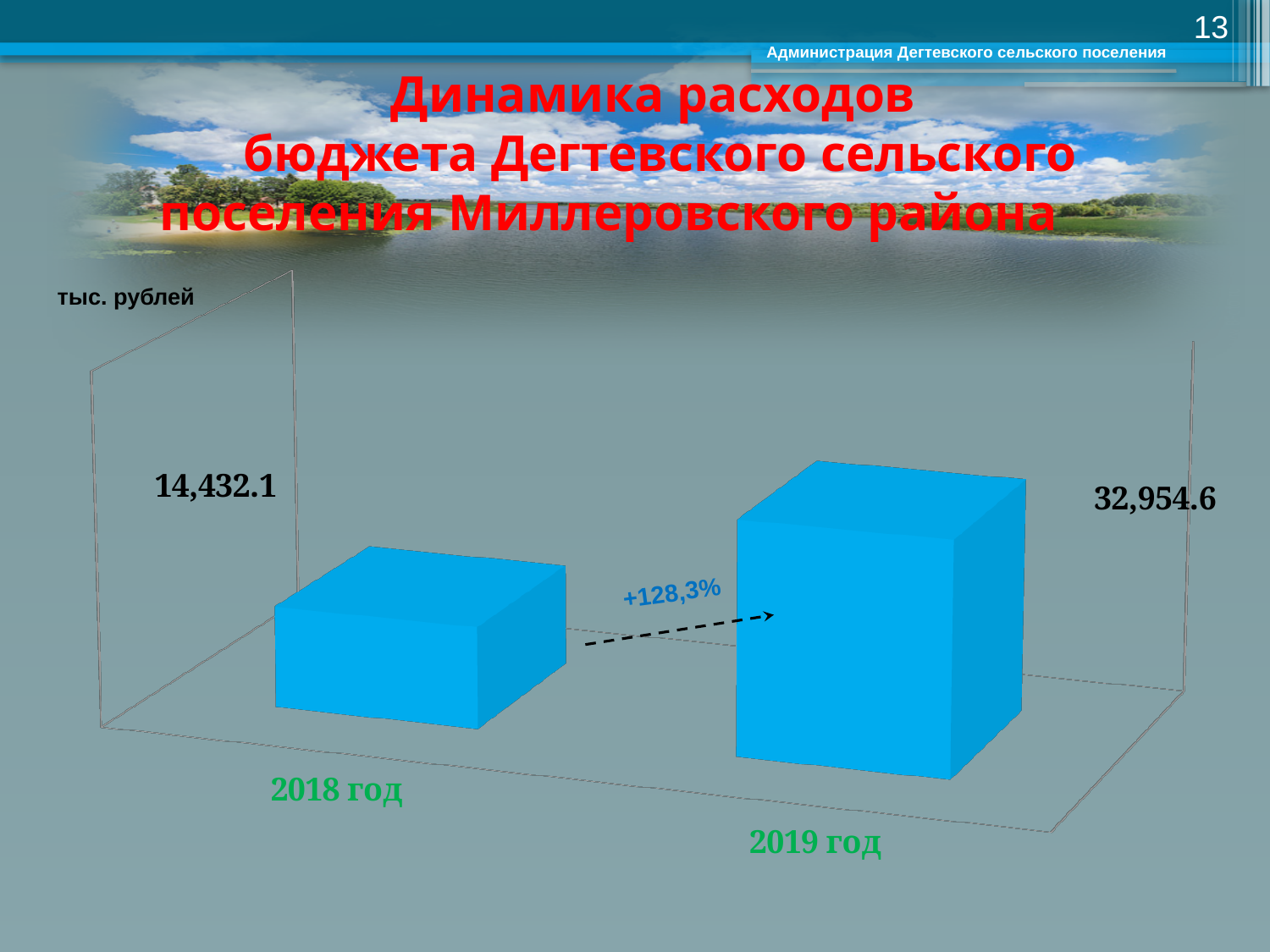
Which year has the lowest value? 2018 год What is the difference between the values for 2019 год and 2018 год? 18,522.5 What is the value for 2019 год? 32,954.6 What is the value for 2018 год? 14,432.1 What percentage change is annotated on the arrow between the two bars? +128,3% Do the values rise or fall from 2018 год to 2019 год? Rise Which year has the highest value? 2019 год How many categories are shown in the chart? 2 What kind of chart is shown on the slide? Bar chart Which is larger, the value for 2018 год or the value for 2019 год? 2019 год What unit is indicated for the values in the chart? тыс. рублей